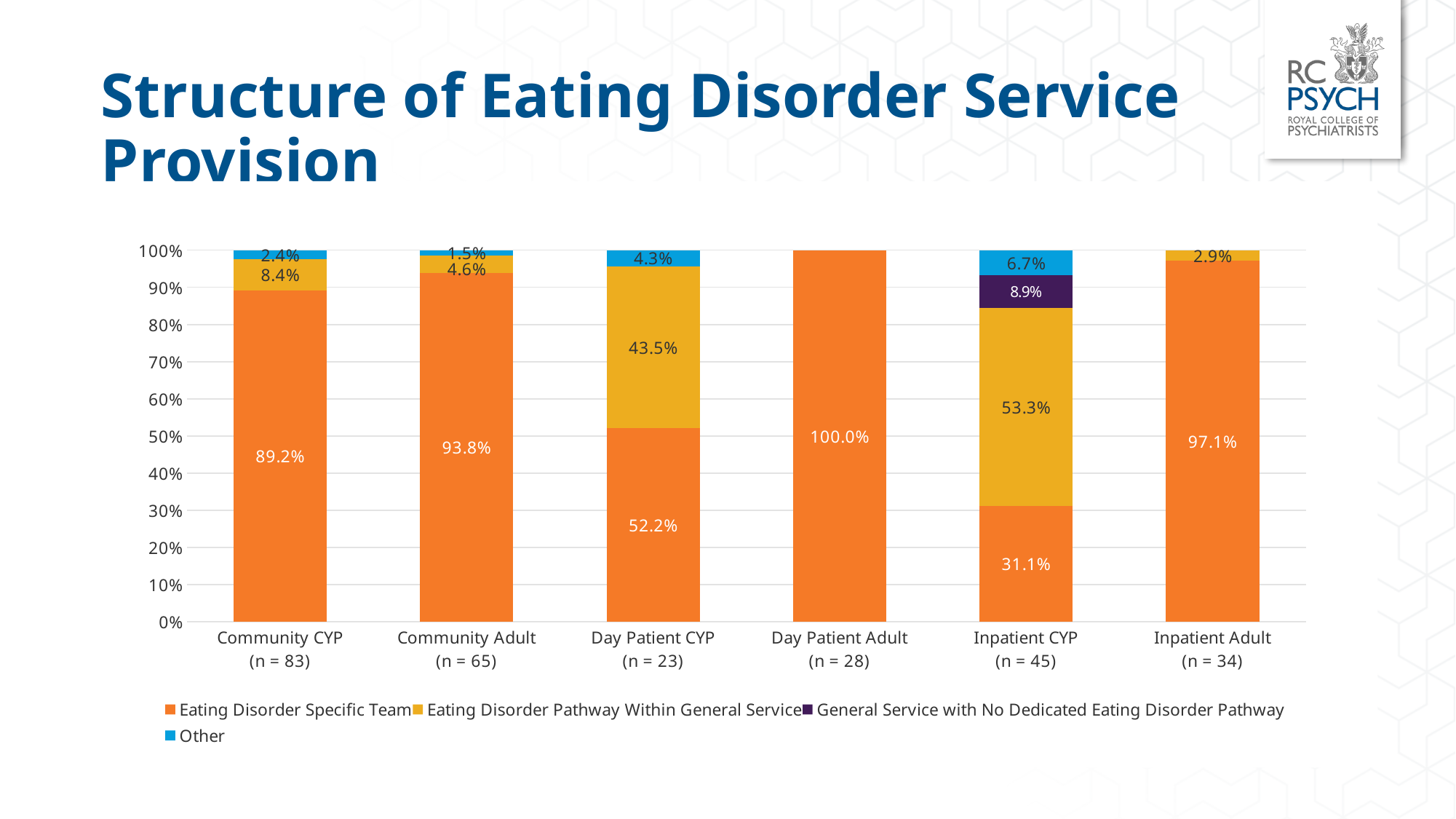
What kind of chart is shown on the slide? Stacked bar chart What percentage of Inpatient CYP services (n = 45) are a General Service with No Dedicated Eating Disorder Pathway? 8.9% Which service type has the lowest share of Eating Disorder Specific Team? Inpatient CYP (n = 45) What is the difference between the Eating Disorder Specific Team share for Community Adult and for Community CYP? 4.6% Which service type has the highest share of Eating Disorder Specific Team? Day Patient Adult (n = 28) How many service types are shown on the x axis? 6 What percentage of Inpatient CYP services (n = 45) are an Eating Disorder Pathway Within General Service? 53.3% What percentage of Day Patient CYP services (n = 23) fall under Other? 4.3% Which service type is the only one with a General Service with No Dedicated Eating Disorder Pathway segment? Inpatient CYP (n = 45) Which is larger for Day Patient CYP: the Eating Disorder Specific Team share or the Eating Disorder Pathway Within General Service share? Eating Disorder Specific Team What percentage of Community CYP services (n = 83) are an Eating Disorder Specific Team? 89.2% How many series does the legend list? 4